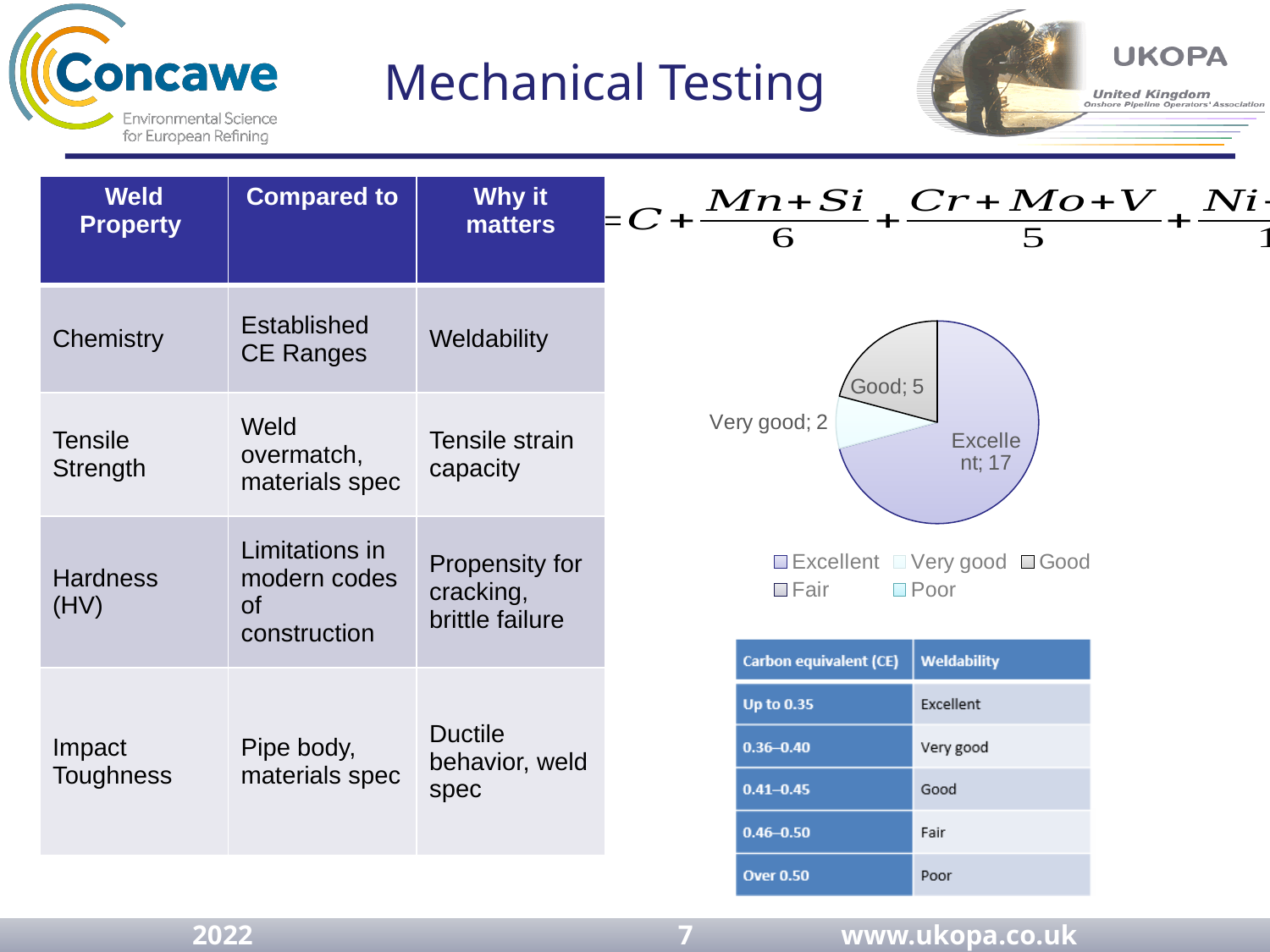
In the pie chart, what is the value for Good? 5 What type of chart is shown on the right side of the slide? Pie chart Which legend entries of the pie chart do not have a labelled slice? Fair and Poor How many slices with data labels are shown in the pie chart? 3 Which category has the largest slice in the pie chart? Excellent How many entries does the legend of the pie chart list? 5 In the pie chart, what is the value for Excellent? 17 Which of the labelled slices in the pie chart has the smallest value? Very good What is the difference between the Excellent and Good values in the pie chart? 12 What is the difference between the Good and Very good values in the pie chart? 3 In the pie chart, what is the value for Very good? 2 In the pie chart, which is larger: Good or Very good? Good